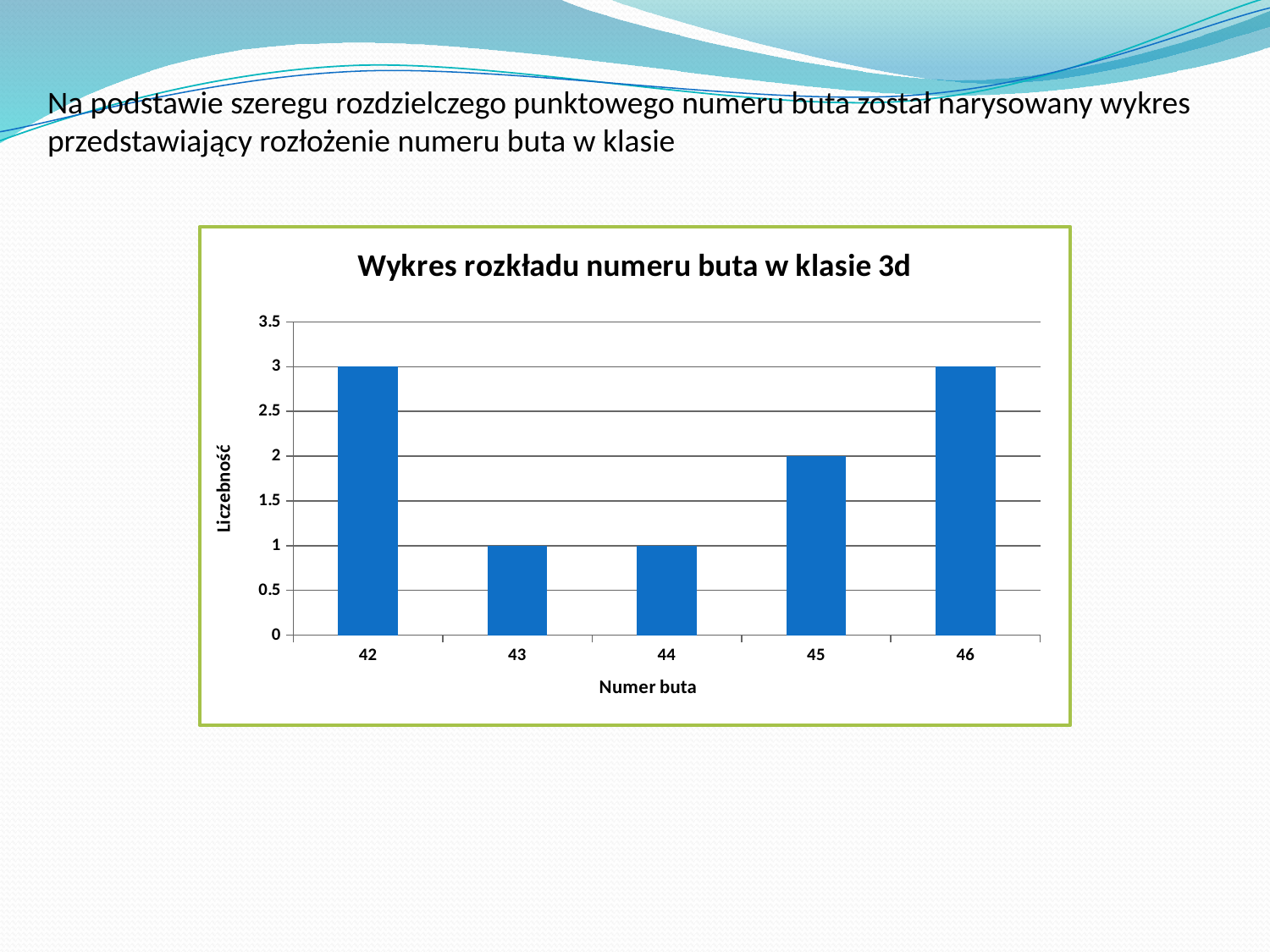
What is the title of the chart? Wykres rozkładu numeru buta w klasie 3d Which shoe sizes have the highest count? 42 and 46 How many shoe size categories are shown on the x axis? 5 Is the value for shoe size 45 greater or less than 1.5? greater Which has a larger count, shoe size 42 or shoe size 45? 42 What is the count (Liczebność) for shoe size 46? 3 What is the difference between the count for shoe size 46 and the count for shoe size 45? 1 What is the count (Liczebność) for shoe size 42? 3 What is the count (Liczebność) for shoe size 45? 2 What type of chart is shown on the slide? bar chart Which shoe sizes have the lowest count? 43 and 44 What is the count (Liczebność) for shoe size 43? 1